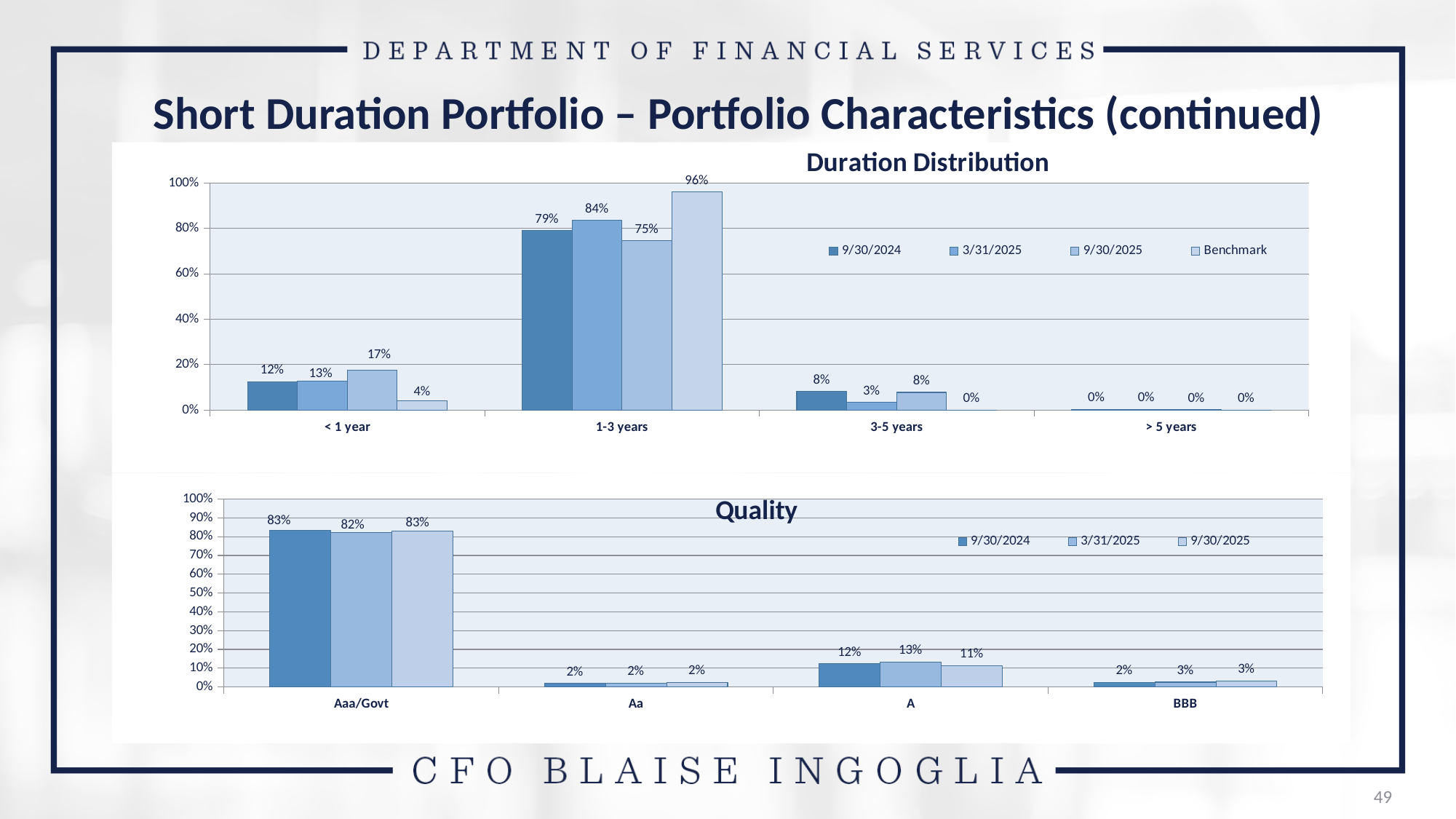
In the Quality chart, what is the 3/31/2025 value for Aaa/Govt? 82% In the Quality chart, how many rating categories are shown on the x axis? 4 In the Duration Distribution chart, how many series does the legend list? 4 In the Duration Distribution chart, which duration bucket has the highest 9/30/2024 value? 1-3 years In the Quality chart, what is the difference between the 9/30/2024 value for Aaa/Govt and the 9/30/2024 value for A? 71% In the Duration Distribution chart, what is the 9/30/2025 value for < 1 year? 17% In the Duration Distribution chart, is the 3/31/2025 value for 3-5 years larger or smaller than the 9/30/2024 value for 3-5 years? smaller In the Duration Distribution chart, what is the difference between the Benchmark and the 9/30/2025 value for 1-3 years? 21% In the Quality chart, what is the 9/30/2025 value for A? 11% In the Duration Distribution chart, what is the Benchmark value for 1-3 years? 96% What type of chart is the Quality chart? Bar chart